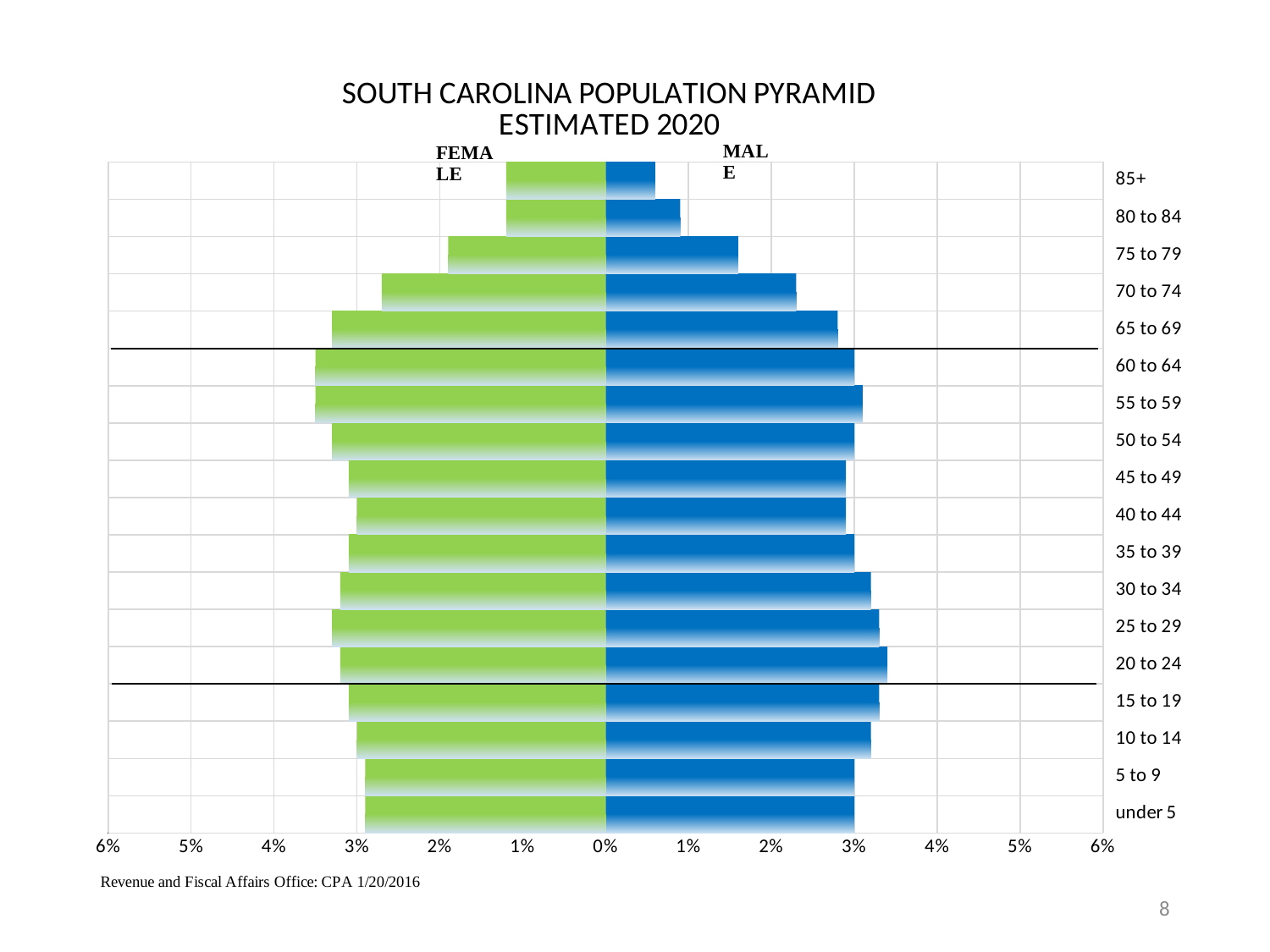
How many series does the chart show? 2 Is the MALE value for 85+ greater or less than 1%? less What kind of chart is shown on the slide? bar chart What is the title of the chart? SOUTH CAROLINA POPULATION PYRAMID ESTIMATED 2020 Is the FEMALE value for 70 to 74 greater or less than 3%? less Is the FEMALE value for 85+ greater or less than 1%? greater For the 70 to 74 age group, which is larger, the FEMALE value or the MALE value? FEMALE How many age groups are shown on the population pyramid? 18 Which age group has the lowest MALE value? 85+ Which series is shown in green on the chart? FEMALE